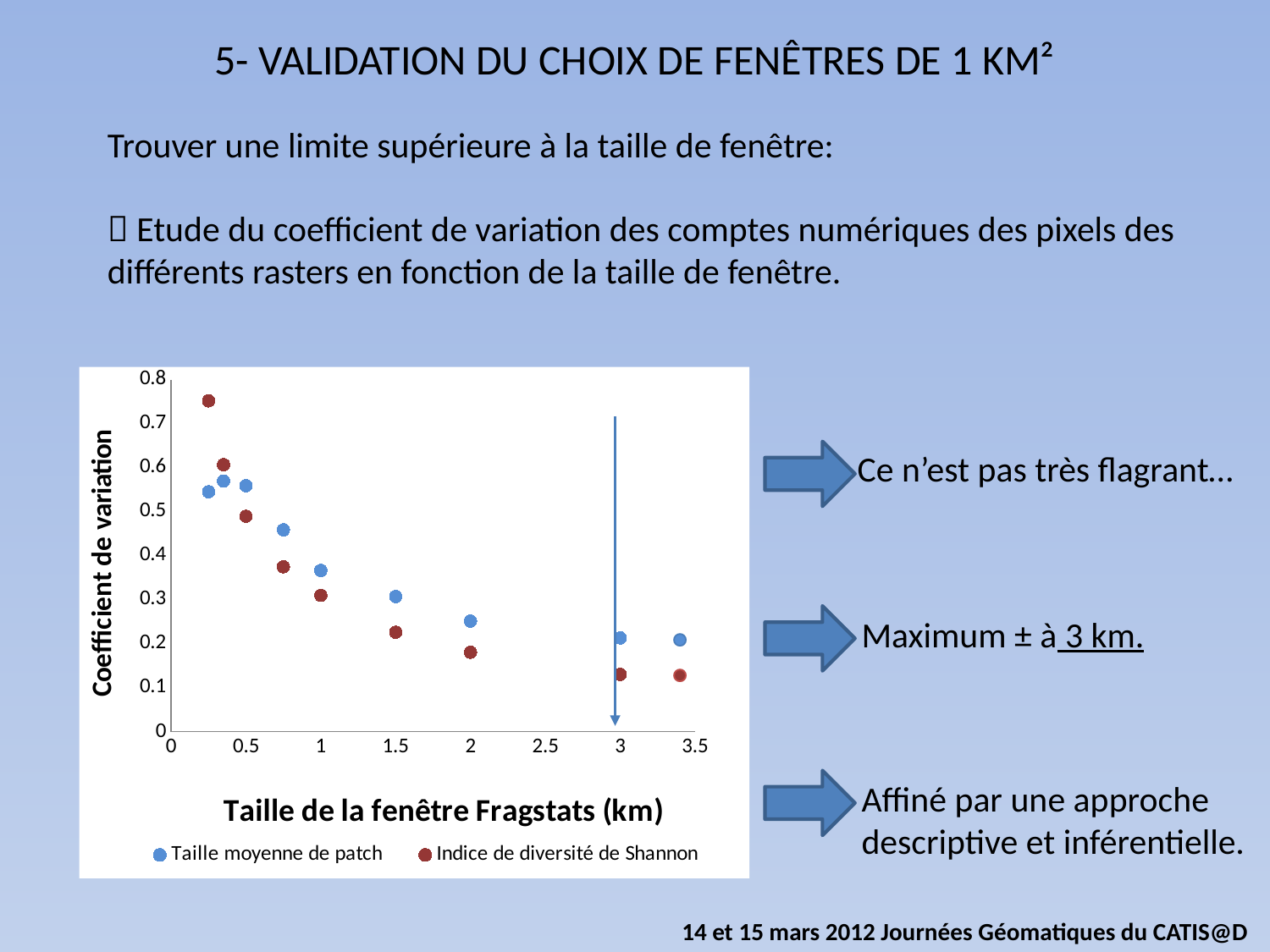
What kind of chart is shown on the slide? Scatter chart At the smallest window size, which series has the higher coefficient of variation? Indice de diversité de Shannon What are the two series named in the chart legend? Taille moyenne de patch and Indice de diversité de Shannon At a window size of 2 km, which series has the higher coefficient of variation? Taille moyenne de patch Is the Taille moyenne de patch value at a window size of 2 km greater or less than 0.2? greater Is the Taille moyenne de patch value at a window size of 1 km greater or less than 0.4? less How many series does the chart legend list? 2 What is the title of the chart's x axis? Taille de la fenêtre Fragstats (km) How does the coefficient of variation change as the window size increases along the x axis? It decreases How many data points are plotted for the Taille moyenne de patch series? 9 Is the Indice de diversité de Shannon value at the smallest window size greater or less than 0.7? greater